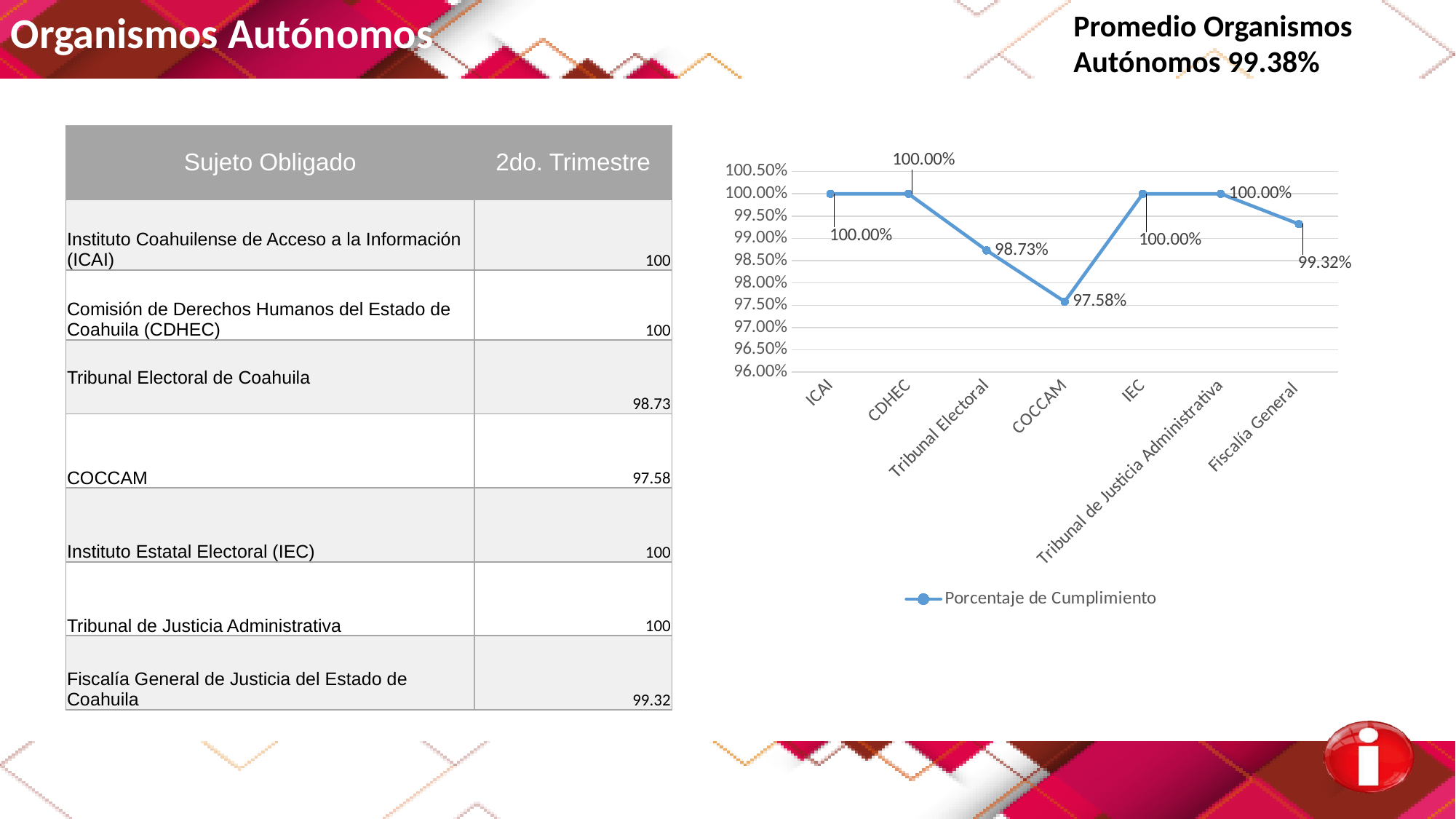
What is the value for COCCAM in the chart? 97.58% What is the difference between the values for ICAI and Fiscalía General? 0.68% How many categories are plotted on the x axis of the chart? 7 What is the value for IEC in the chart? 100.00% How many series does the chart legend list? 1 Which is larger, the value for Tribunal Electoral or the value for Fiscalía General? Fiscalía General What is the difference between the values for Tribunal Electoral and COCCAM? 1.15% What is the value for Tribunal Electoral in the chart? 98.73% Which category has the lowest value in the chart? COCCAM What is the value for Fiscalía General in the chart? 99.32% What type of chart is shown on the slide? line chart What is the name of the series shown in the chart legend? Porcentaje de Cumplimiento